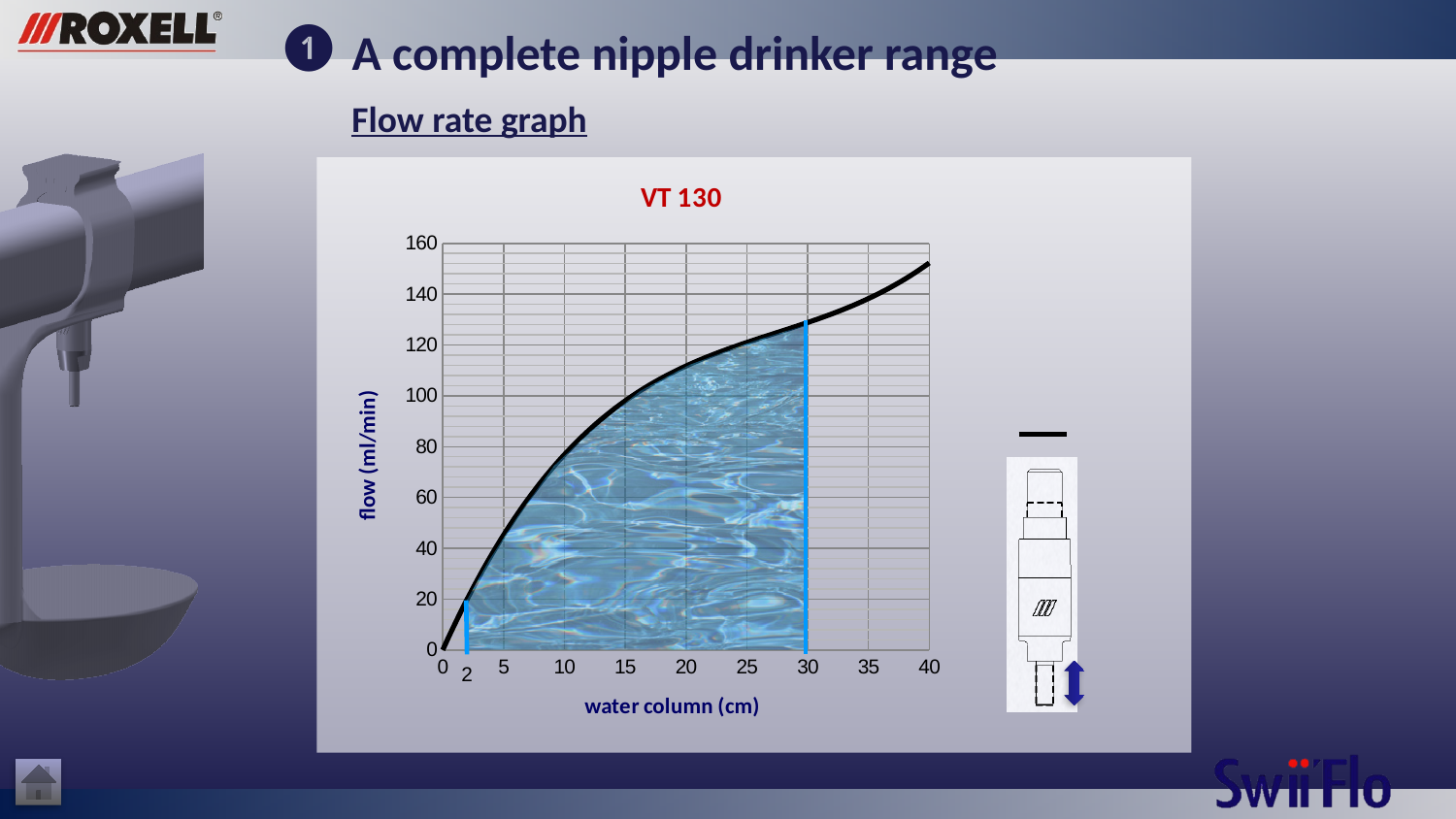
Does the flow rise or fall as the water column increases along the x axis? rises Is the flow at a water column of 20 cm greater or less than 100 ml/min? greater Is the flow at a water column of 5 cm greater or less than 60 ml/min? less Which water column gives the higher flow, 15 cm or 35 cm? 35 cm Is the flow at a water column of 10 cm greater or less than 60 ml/min? greater What is the label of the x axis of the chart? water column (cm) What is the title of the chart? VT 130 What kind of chart is shown on the slide? line chart